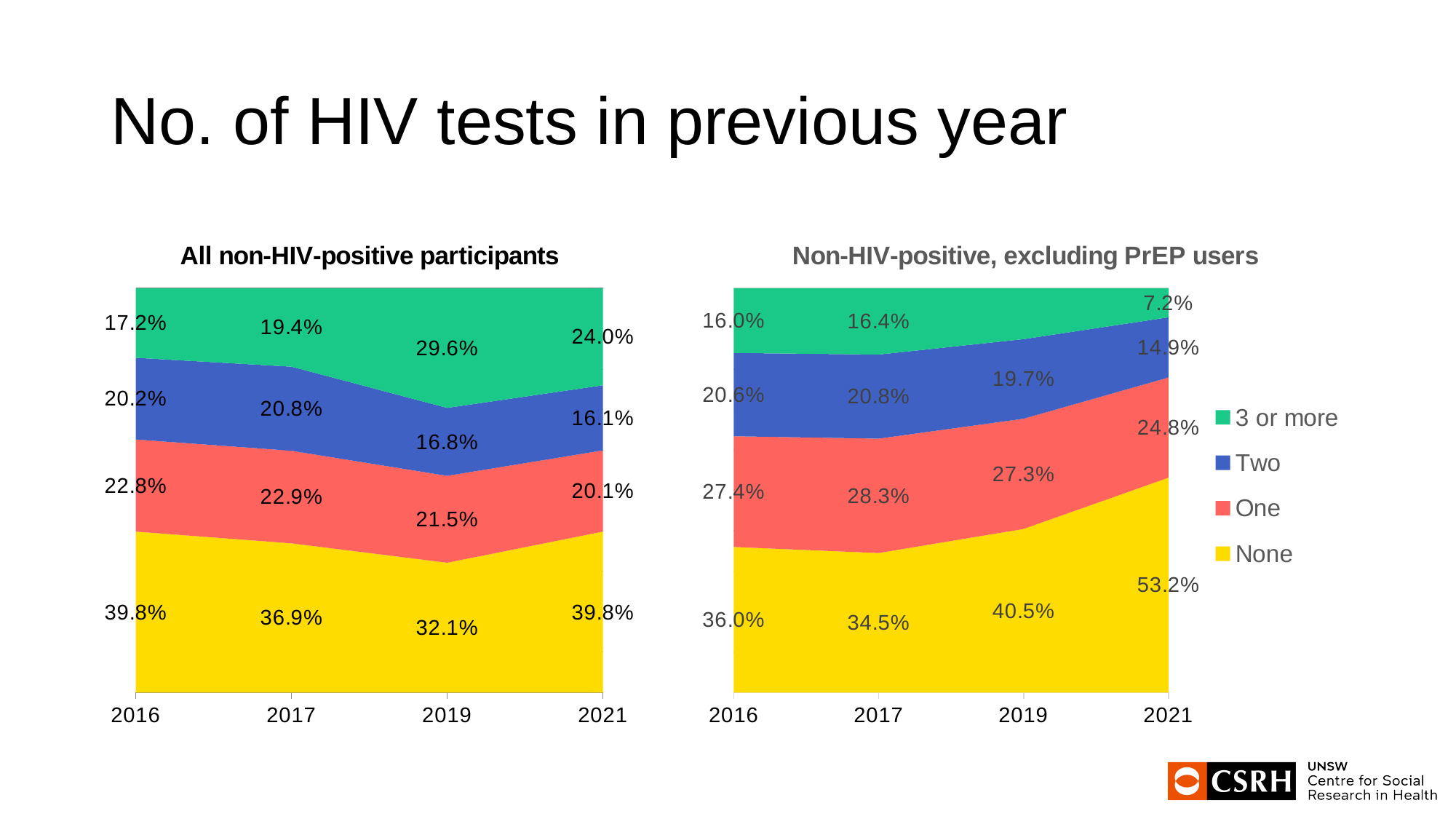
In the 'Non-HIV-positive, excluding PrEP users' chart, what is the difference between the 'None' values for 2021 and 2019? 12.7% In the 'Non-HIV-positive, excluding PrEP users' chart, does the 'None' value rise or fall from 2017 to 2021? Rise In the 'All non-HIV-positive participants' chart, in which year is the '3 or more' value highest? 2019 What kind of chart is the 'Non-HIV-positive, excluding PrEP users' chart? Stacked area chart How many years are shown on the x axis of the 'All non-HIV-positive participants' chart? 4 In the 'Non-HIV-positive, excluding PrEP users' chart, what is the value for 'Two' in 2019? 19.7% In the 'All non-HIV-positive participants' chart, which is larger in 2021: 'One' or 'Two'? One In the 'All non-HIV-positive participants' chart, what is the value for '3 or more' in 2021? 24.0% In the 'Non-HIV-positive, excluding PrEP users' chart, in which year is the '3 or more' value lowest? 2021 How many series does the legend list? 4 In the 'All non-HIV-positive participants' chart, what is the value for 'None' in 2019? 32.1% In the 'Non-HIV-positive, excluding PrEP users' chart, what is the value for 'None' in 2021? 53.2%